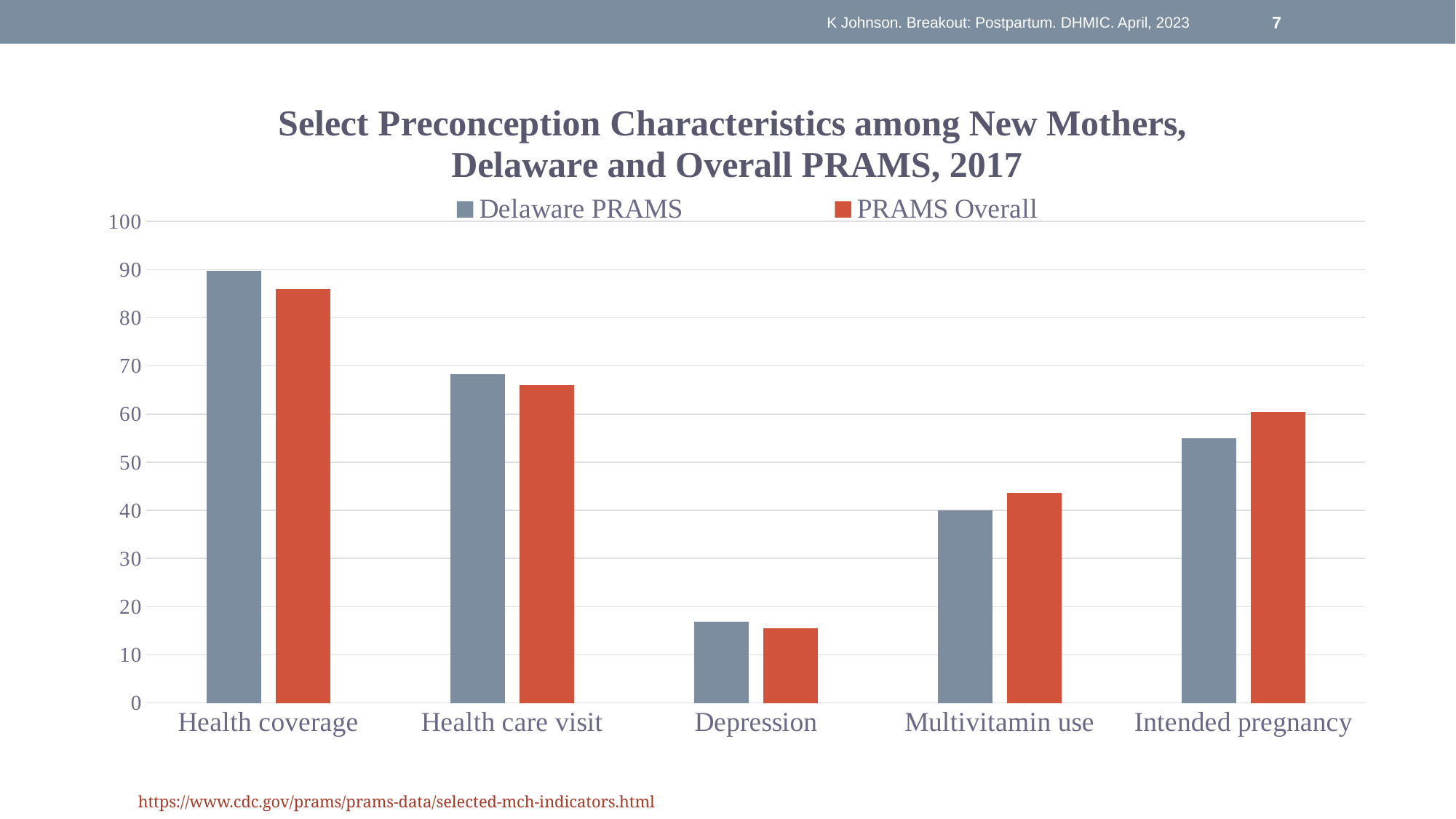
For Health coverage, which is larger: Delaware PRAMS or PRAMS Overall? Delaware PRAMS How many series does the legend list? 2 What kind of chart is shown on the slide? bar chart Which colour represents PRAMS Overall in the chart? red Is the Delaware PRAMS value for Depression greater or less than 20? less Is the PRAMS Overall value for Multivitamin use greater or less than 50? less Which category has the lowest value for PRAMS Overall? Depression Is the PRAMS Overall value for Intended pregnancy greater or less than 50? greater For Intended pregnancy, which is larger: Delaware PRAMS or PRAMS Overall? PRAMS Overall Which category has the highest value for Delaware PRAMS? Health coverage How many categories are shown on the x axis? 5